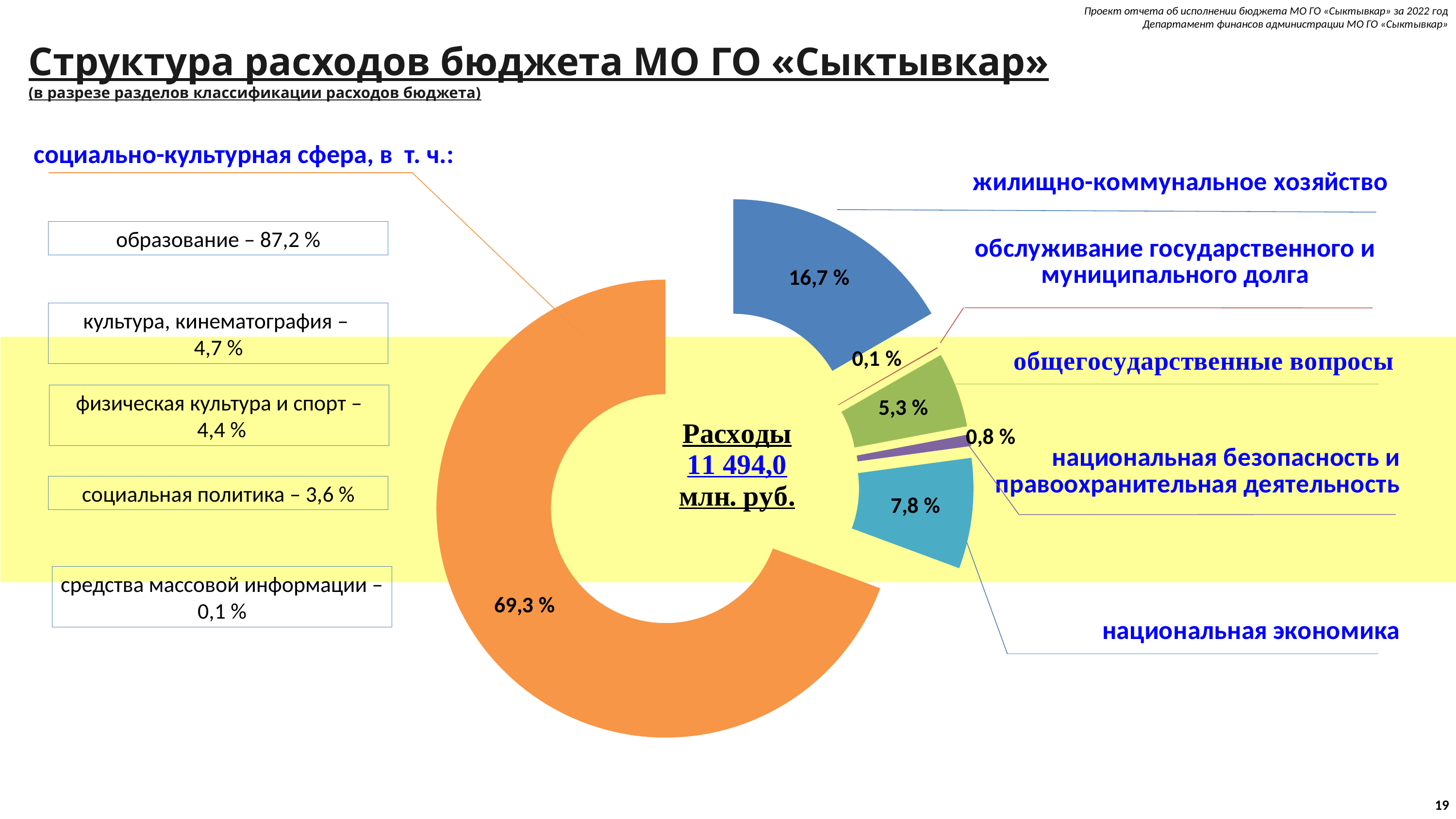
What share of expenditures goes to жилищно-коммунальное хозяйство? 16,7 % What is the difference in share between жилищно-коммунальное хозяйство and национальная экономика? 8,9 % What total expenditure amount is shown in the centre of the chart? 11 494,0 млн. руб. What share of expenditures goes to социально-культурная сфера? 69,3 % What share of expenditures goes to национальная экономика? 7,8 % What share of expenditures goes to обслуживание государственного и муниципального долга? 0,1 % Which section has the smallest share of expenditures? обслуживание государственного и муниципального долга Which has a larger share: общегосударственные вопросы or национальная безопасность и правоохранительная деятельность? общегосударственные вопросы Which section has the largest share of expenditures? социально-культурная сфера What kind of chart is shown on the slide? Pie (doughnut) chart How many sections (slices) does the chart show? 6 What share of expenditures goes to общегосударственные вопросы? 5,3 %